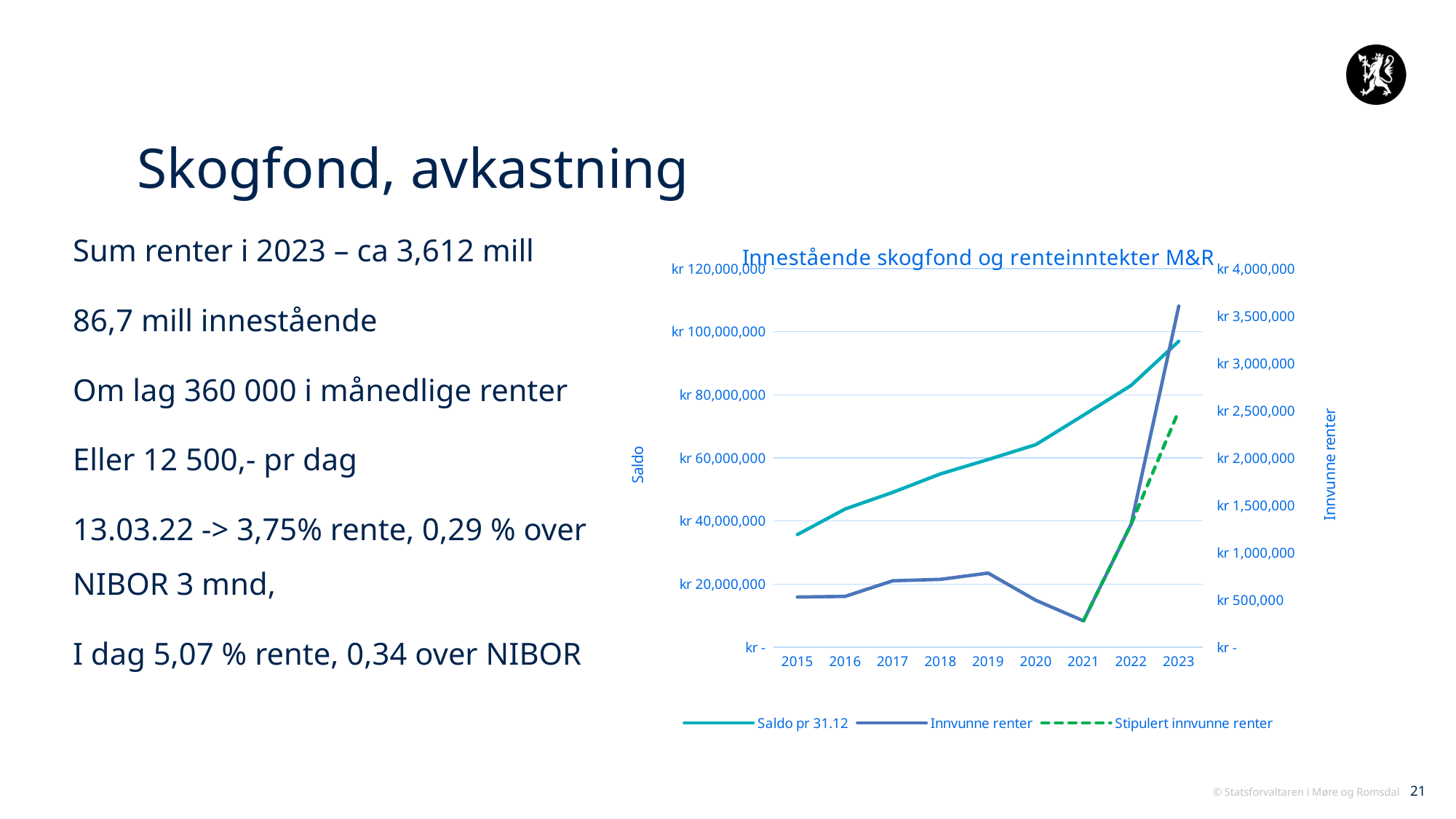
In which year is the Innvunne renter series highest? 2023 In which year is the Saldo pr 31.12 series highest? 2023 Is the Innvunne renter value for 2023 greater or less than kr 3,000,000? greater What is the title of the chart? Innestående skogfond og renteinntekter M&R In which year is the Innvunne renter series lowest? 2021 Does the Saldo pr 31.12 series rise or fall from 2015 to 2023? Rise Which is larger, the Innvunne renter value for 2019 or for 2021? 2019 What kind of chart is shown on the slide? Line chart What is the label of the right-hand vertical axis of the chart? Innvunne renter Is the Saldo pr 31.12 value for 2023 greater or less than kr 80,000,000? greater How many series does the chart legend list? 3 How many years are shown on the x axis of the chart? 9